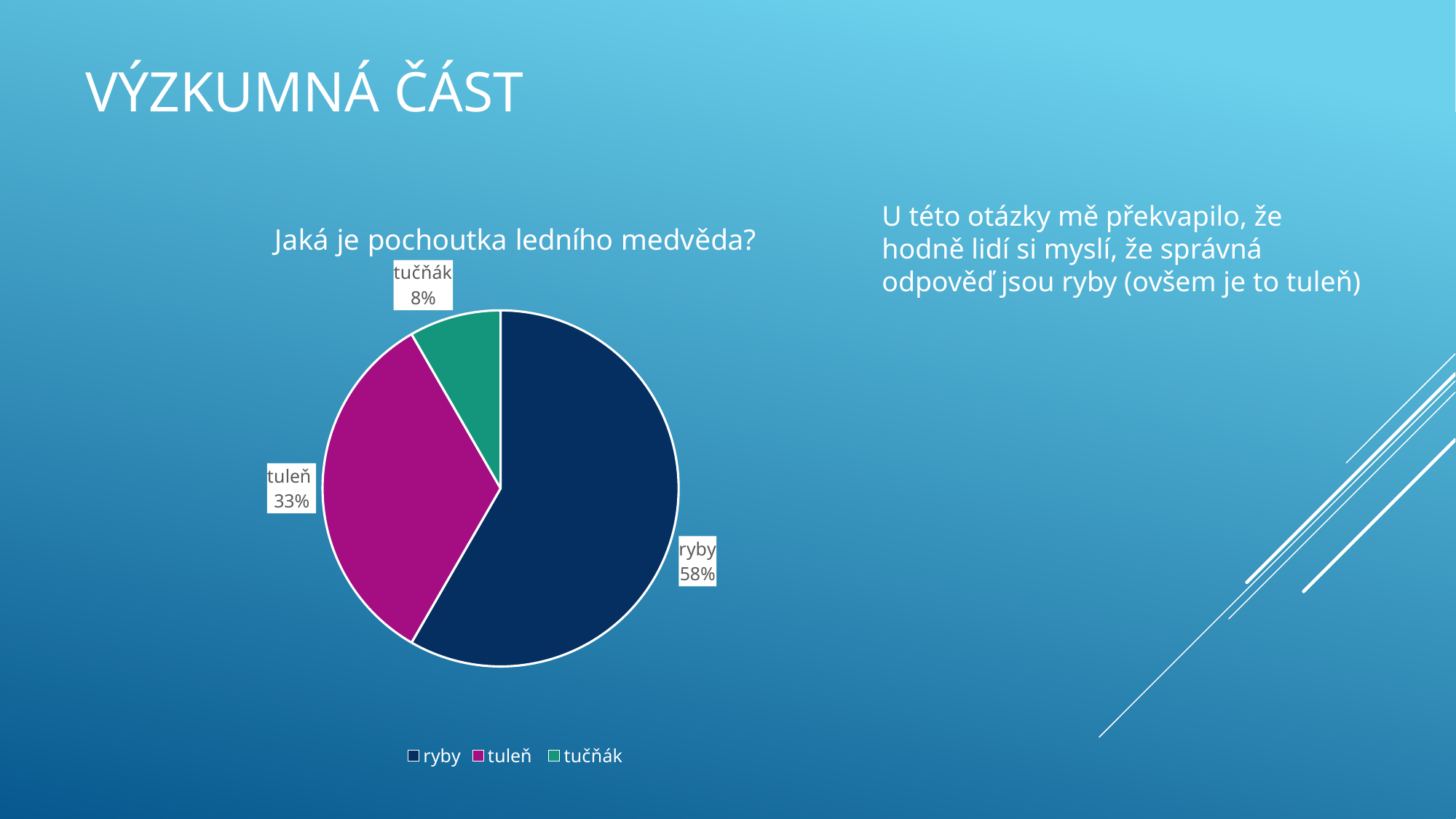
Which category is shown in the magenta colour? tuleň What is the difference in percentage points between the 'tuleň' and 'tučňák' slices? 25 What share of the pie does the 'tuleň' slice represent? 33% What is the difference in percentage points between the 'ryby' and 'tuleň' slices? 25 What kind of chart is shown on the slide? pie chart What share of the pie does the 'tučňák' slice represent? 8% What share of the pie does the 'ryby' slice represent? 58% How many categories does the pie chart have? 3 Which category has the largest slice of the pie? ryby Which category has the smallest slice of the pie? tučňák Which slice is larger, 'tuleň' or 'tučňák'? tuleň What is the title of the chart? Jaká je pochoutka ledního medvěda?